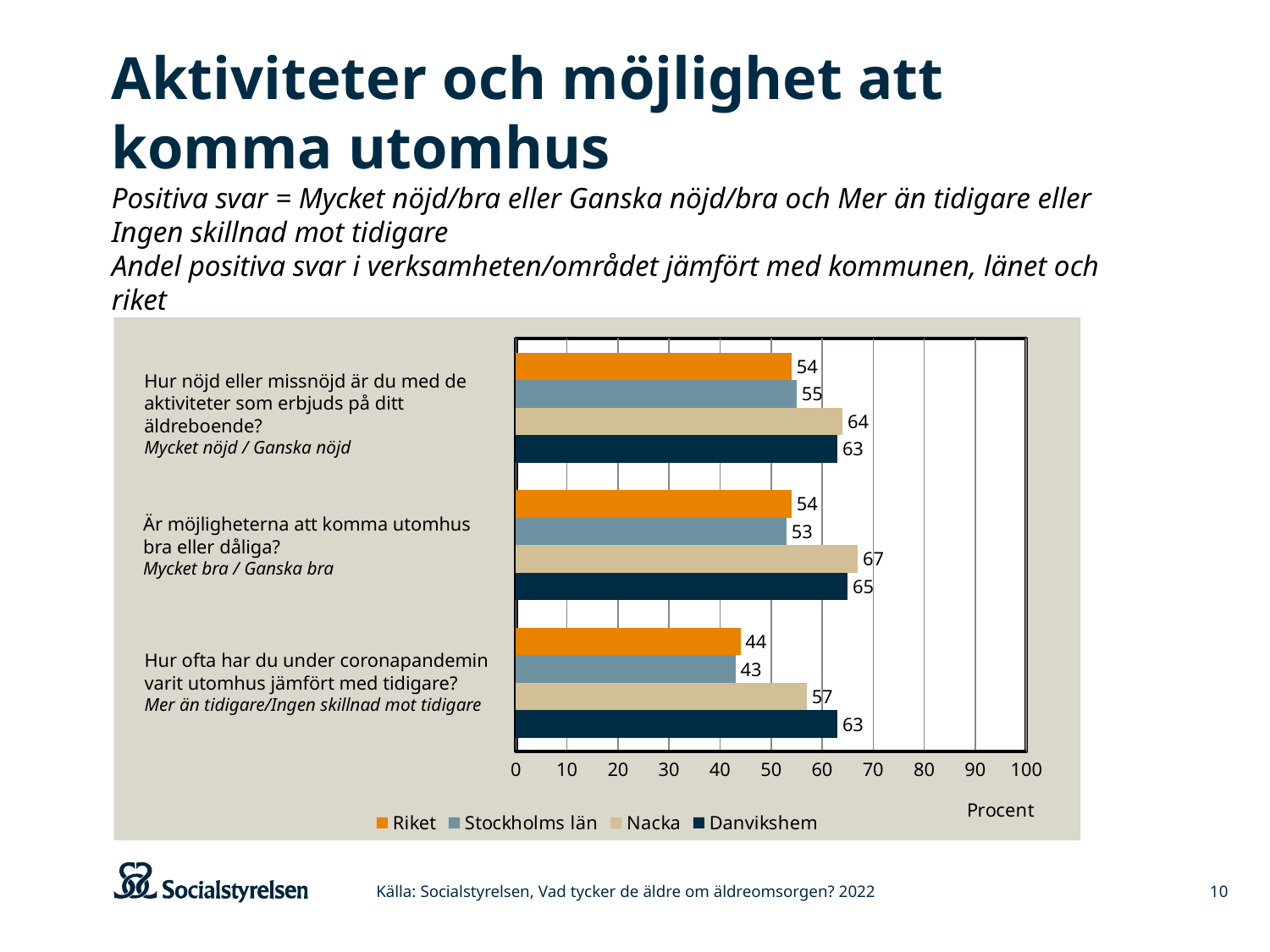
What is the difference between Danvikshem and Riket for the question about how often residents have been outdoors during the pandemic compared to before? 19 What value does Stockholms län have for the question about whether opportunities to get outdoors are good or bad? 53 What value does Danvikshem have for the question about how often residents have been outdoors during the pandemic compared to before? 63 What is the label on the horizontal axis of the chart? Procent How many series does the legend list? 4 For the question about satisfaction with activities offered, which is larger: the value for Nacka or the value for Danvikshem? Nacka What kind of chart is shown on the slide? Bar chart What value does Nacka have for the question about satisfaction with activities offered at the care home (Mycket nöjd / Ganska nöjd)? 64 Which series has the highest value for the question about opportunities to get outdoors (Mycket bra / Ganska bra)? Nacka What value does Riket have for the question about how often residents have been outdoors during the pandemic compared to before? 44 Which series has the lowest value for the question about how often residents have been outdoors during the pandemic compared to before? Stockholms län How many questions (categories) are shown on the chart? 3